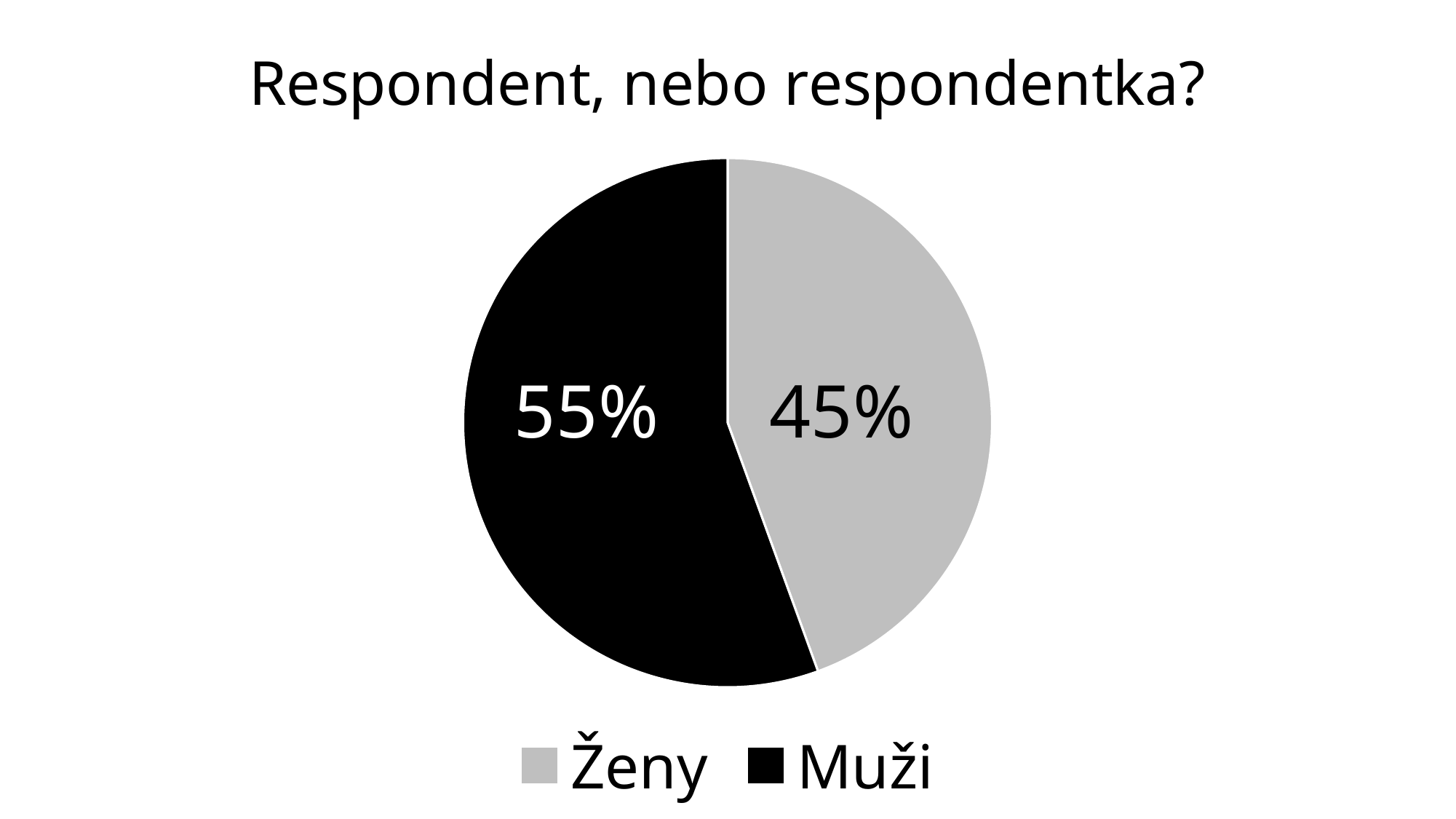
Which is larger, the share for Ženy or the share for Muži? Muži What share of the pie does the Ženy slice represent? 45% What percentage of the pie is Muži? 55% How many slices does the pie chart have? 2 Which category has the smallest share of the pie? Ženy What type of chart is shown on the slide? pie chart What percentage of the pie is Ženy? 45% Which category has the largest share of the pie? Muži What is the difference in percentage points between Muži and Ženy? 10 What colour is the Muži slice? black How many entries does the legend list? 2 What is the title of the chart? Respondent, nebo respondentka?